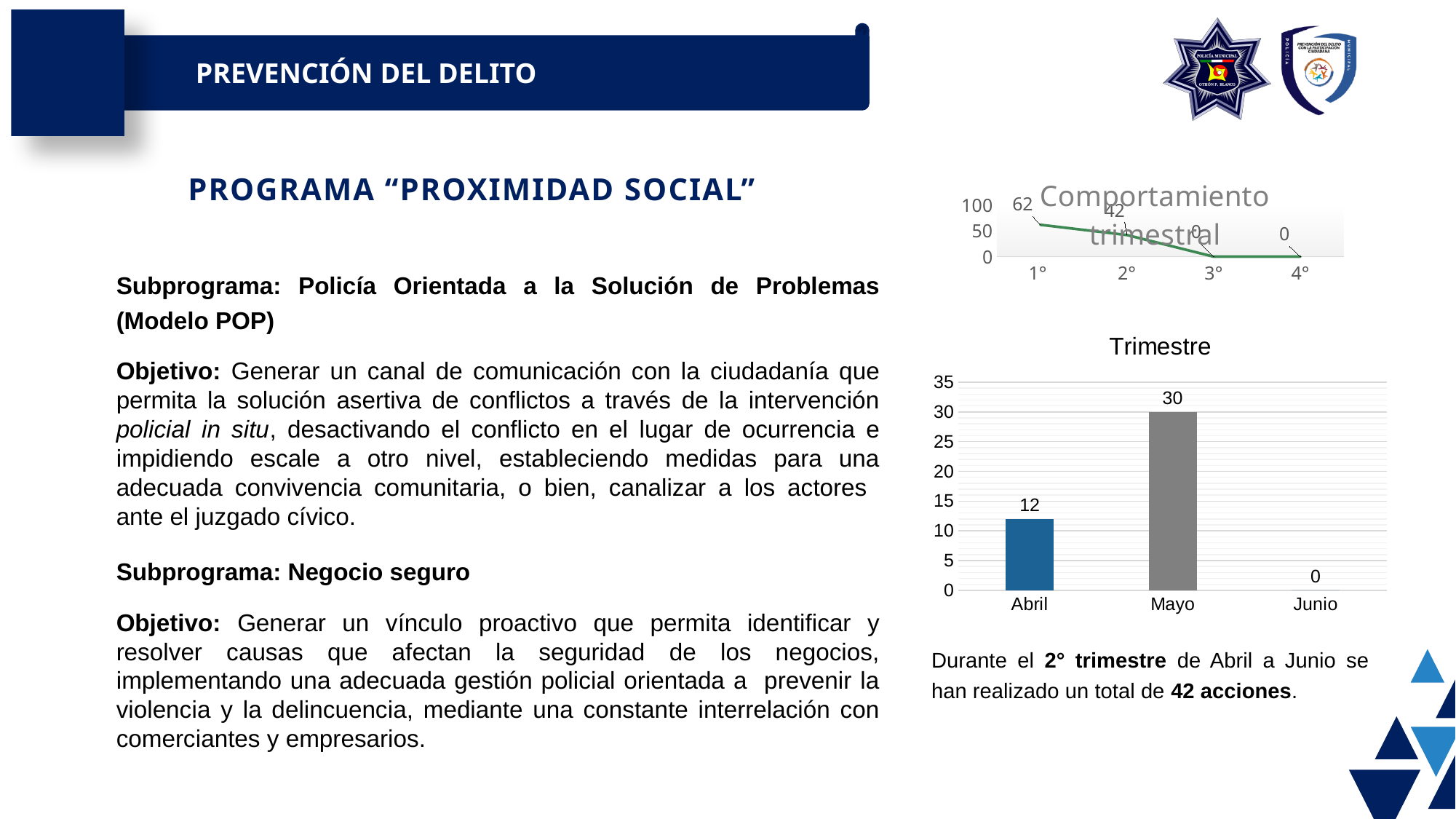
In the "Comportamiento trimestral" line chart, do the values rise or fall from 1° to 4°? Fall In the "Trimestre" bar chart, what is the value for Abril? 12 In the "Trimestre" bar chart, what is the value for Junio? 0 In the "Comportamiento trimestral" line chart, what is the value for 2°? 42 In the "Trimestre" bar chart, what is the difference between the values for Mayo and Abril? 18 In the "Trimestre" bar chart, what is the value for Mayo? 30 In the "Comportamiento trimestral" line chart, what is the difference between the values for 1° and 2°? 20 In the "Trimestre" bar chart, which month has the lowest value? Junio In the "Trimestre" bar chart, which month has the highest value? Mayo In the "Comportamiento trimestral" line chart, what is the value for 1°? 62 In the "Trimestre" bar chart, how many months are shown on the x axis? 3 What kind of chart is the "Trimestre" chart? Bar chart